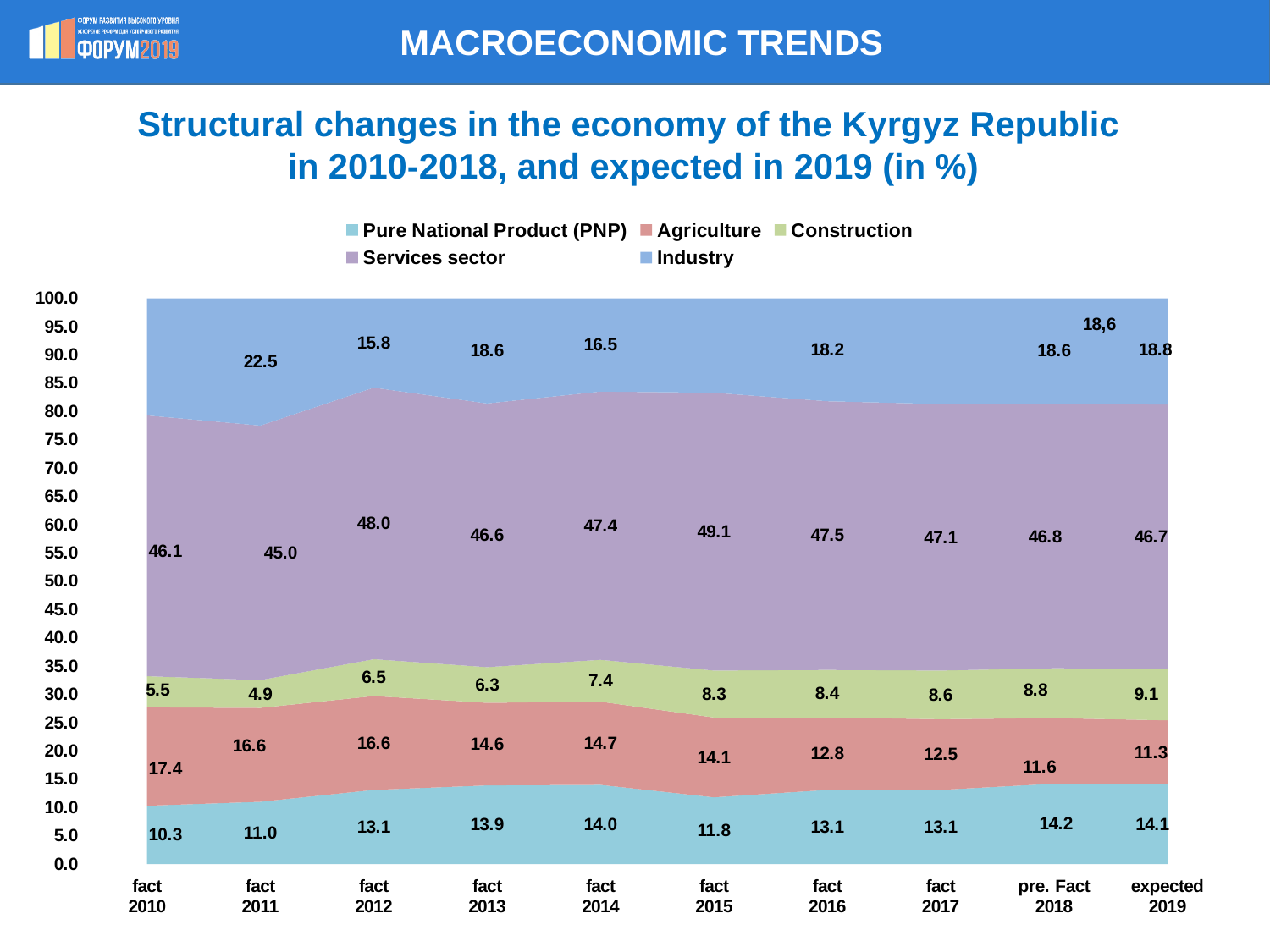
What is the Pure National Product (PNP) value for pre. Fact 2018? 14.2 What is the Services sector value for fact 2015? 49.1 In which year is the Agriculture value highest? fact 2010 What is the Construction value for expected 2019? 9.1 Does the Construction value rise or fall from fact 2014 to expected 2019? rise Which is larger, the Pure National Product (PNP) value for fact 2010 or for fact 2014? fact 2014 How many series does the legend list? 5 What is the Industry value for fact 2011? 22.5 In which year is the Construction value lowest? fact 2011 What is the difference between the Agriculture values for fact 2010 and expected 2019? 6.1 What is the Agriculture value for fact 2010? 17.4 How many years (categories) are shown on the x axis? 10